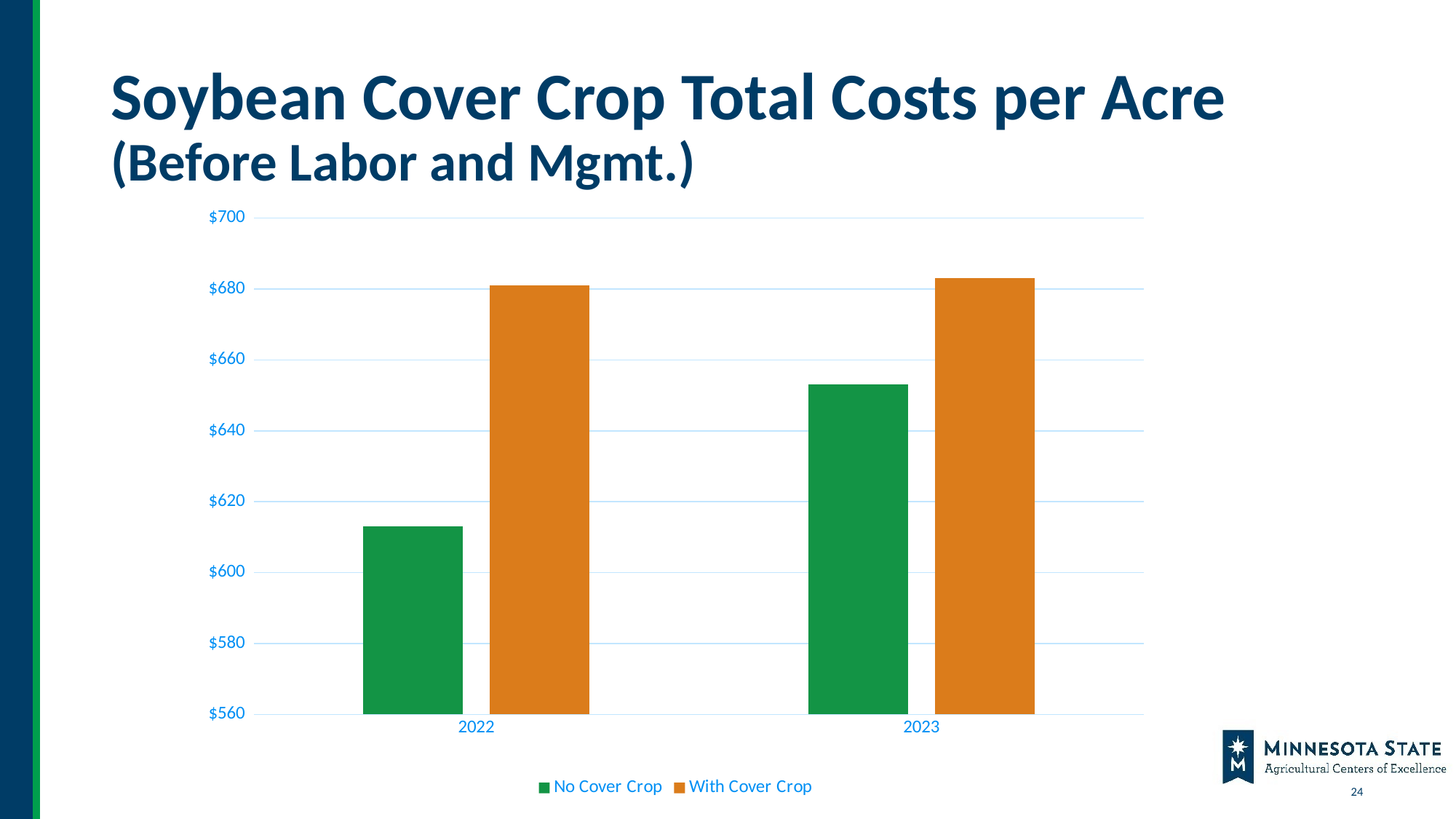
Is the value for With Cover Crop in 2023 greater or less than $660? greater Which bar is the lowest on the chart? No Cover Crop in 2022 What kind of chart is shown on the slide? bar chart For No Cover Crop, which year has the higher cost: 2022 or 2023? 2023 How many series does the legend list? 2 In 2022, which is larger: No Cover Crop or With Cover Crop? With Cover Crop Does the No Cover Crop cost rise or fall from 2022 to 2023? rise Is the value for No Cover Crop in 2022 greater or less than $620? less Is the value for No Cover Crop in 2023 greater or less than $640? greater In 2023, which is larger: No Cover Crop or With Cover Crop? With Cover Crop What colour are the With Cover Crop bars? orange How many years are shown on the x axis? 2